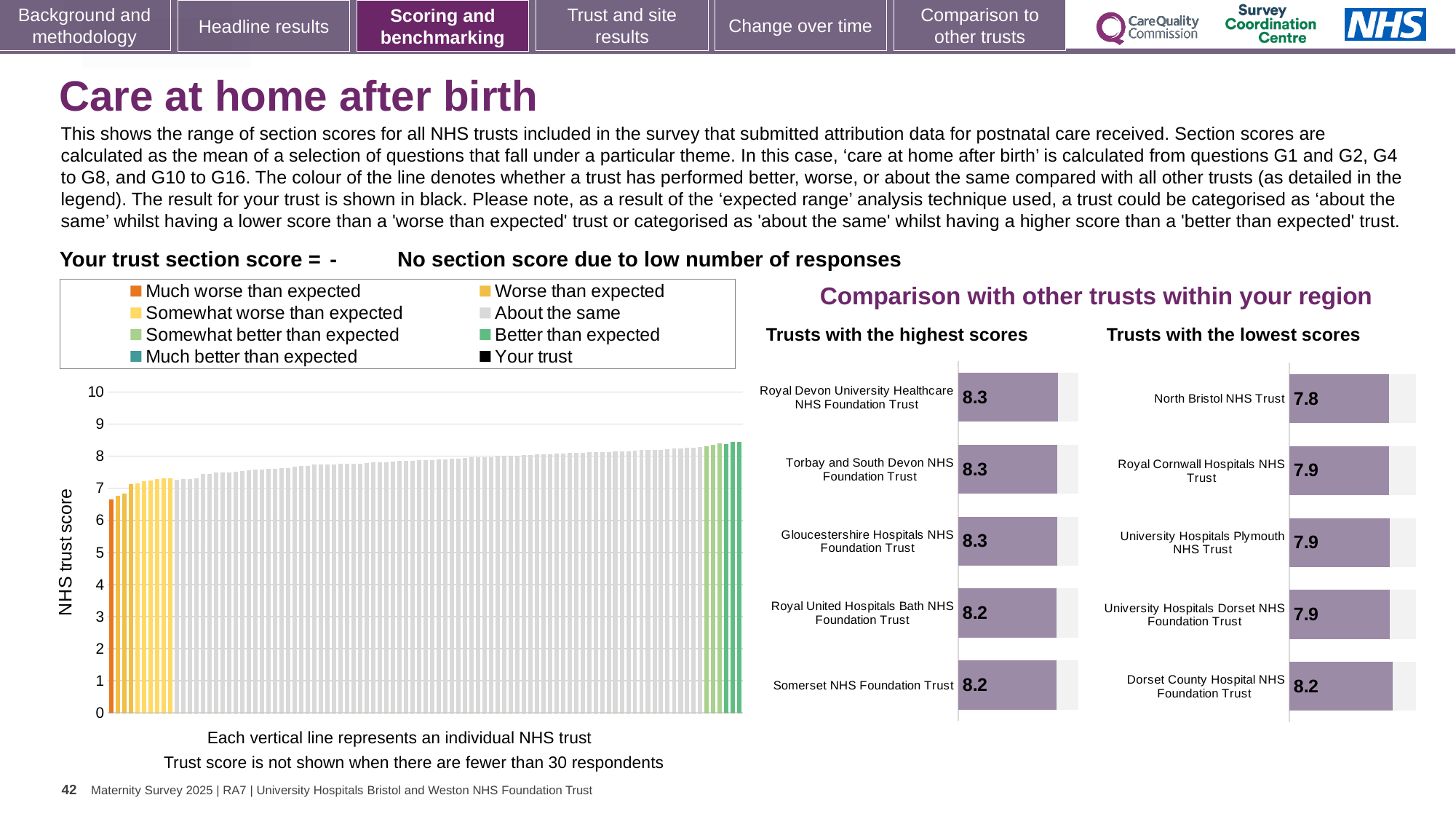
In the 'Trusts with the highest scores' chart, what is the score for Somerset NHS Foundation Trust? 8.2 In the 'Trusts with the highest scores' chart, what is the score for Royal Devon University Healthcare NHS Foundation Trust? 8.3 In the 'Trusts with the lowest scores' chart, what is the score for North Bristol NHS Trust? 7.8 In the 'Trusts with the lowest scores' chart, which trust has the lowest score? North Bristol NHS Trust In the large 'NHS trust score' chart on the left, do the bar values rise or fall from left to right? Rise What kind of chart is the large chart on the left with the 'NHS trust score' axis? Bar chart In the 'Trusts with the lowest scores' chart, which trust has the highest score? Dorset County Hospital NHS Foundation Trust How many entries does the legend above the 'NHS trust score' chart list? 8 How many trusts are shown in the 'Trusts with the highest scores' chart? 5 In the large 'NHS trust score' chart on the left, is the value of the tallest bar greater or less than 9? less Which has the larger score: Gloucestershire Hospitals NHS Foundation Trust in the highest scores chart or University Hospitals Plymouth NHS Trust in the lowest scores chart? Gloucestershire Hospitals NHS Foundation Trust What is the difference between the score for Royal Devon University Healthcare NHS Foundation Trust in the highest scores chart and the score for North Bristol NHS Trust in the lowest scores chart? 0.5